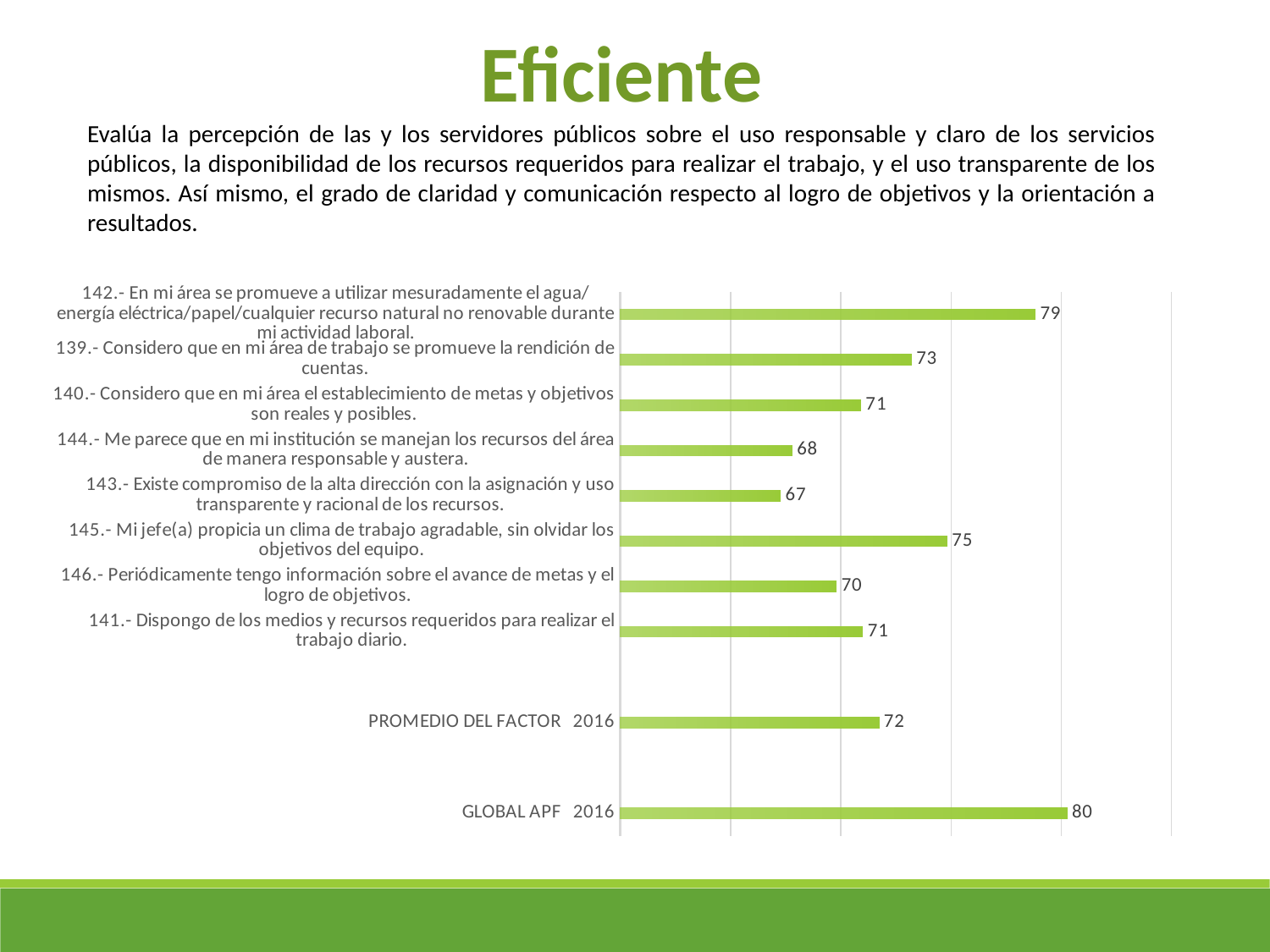
What is the value for item 145 (Mi jefe(a) propicia un clima de trabajo agradable, sin olvidar los objetivos del equipo)? 75 What is the value for item 143 (Existe compromiso de la alta dirección con la asignación y uso transparente y racional de los recursos)? 67 Which category has the lowest value in the chart? 143.- Existe compromiso de la alta dirección con la asignación y uso transparente y racional de los recursos. What type of chart is shown on the slide? Bar chart How many bars are shown in the chart? 10 What is the difference between the value for GLOBAL APF 2016 and PROMEDIO DEL FACTOR 2016? 8 What is the title of the slide? Eficiente What is the value for GLOBAL APF 2016? 80 Which has a larger value: item 139 (rendición de cuentas) or item 146 (información sobre el avance de metas)? 139.- Considero que en mi área de trabajo se promueve la rendición de cuentas. What is the difference between the value for item 142 and item 144? 11 What is the value for PROMEDIO DEL FACTOR 2016? 72 Which category has the highest value in the chart? GLOBAL APF 2016